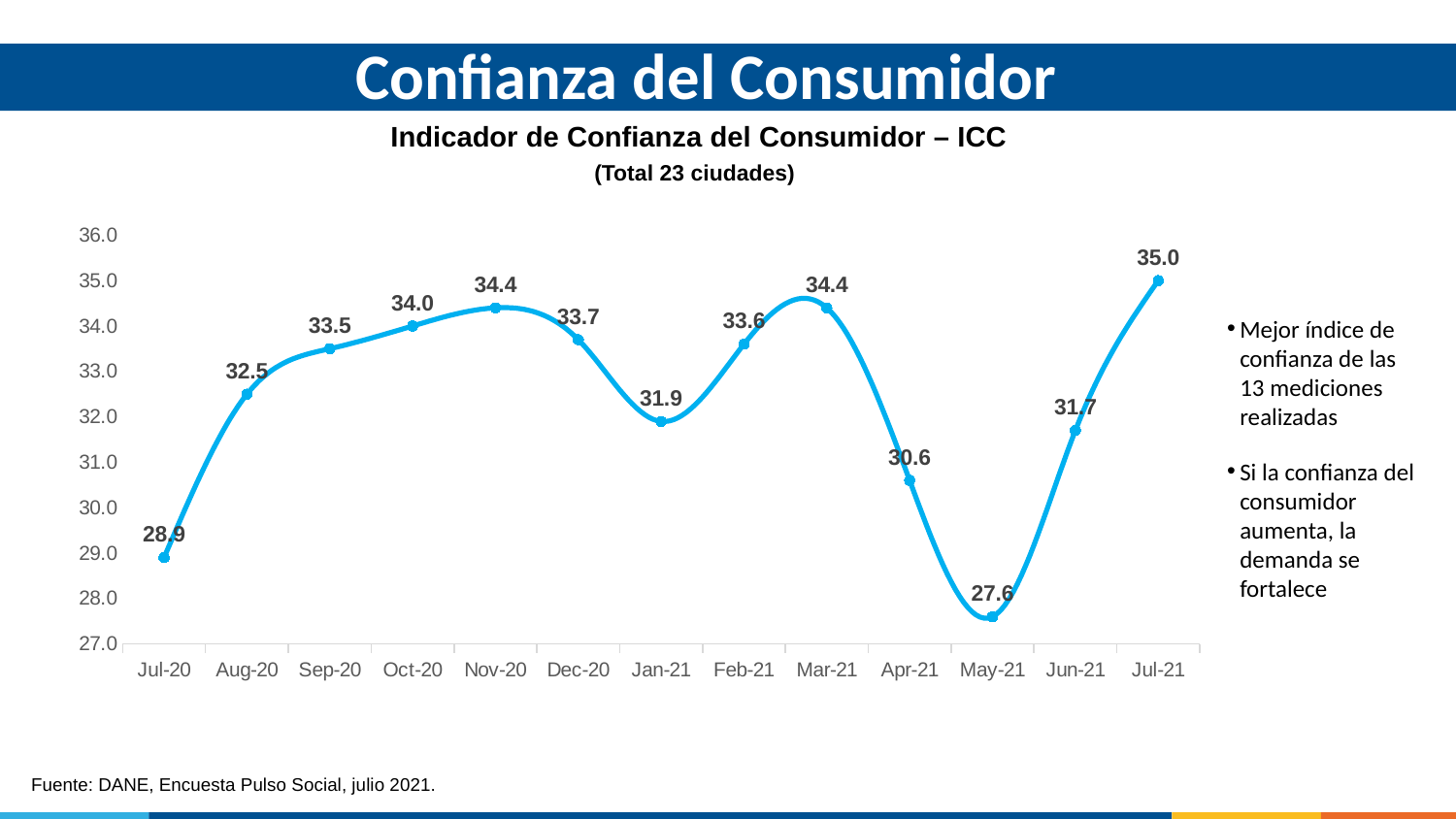
Which month has the highest ICC value? Jul-21 Which is larger, the ICC value for Dec-20 or for Feb-21? Dec-20 What is the ICC value for Jan-21? 31.9 What is the difference between the ICC values for Jul-21 and May-21? 7.4 What kind of chart is shown on the slide? line chart Which month has the lowest ICC value? May-21 Does the ICC value rise or fall from Mar-21 to May-21? fall How many months are plotted on the chart? 13 What is the difference between the ICC values for Jul-21 and Jul-20? 6.1 Is the ICC value for Apr-21 greater or less than 31.0? less What is the ICC value for Jul-21? 35.0 What is the ICC value for May-21? 27.6